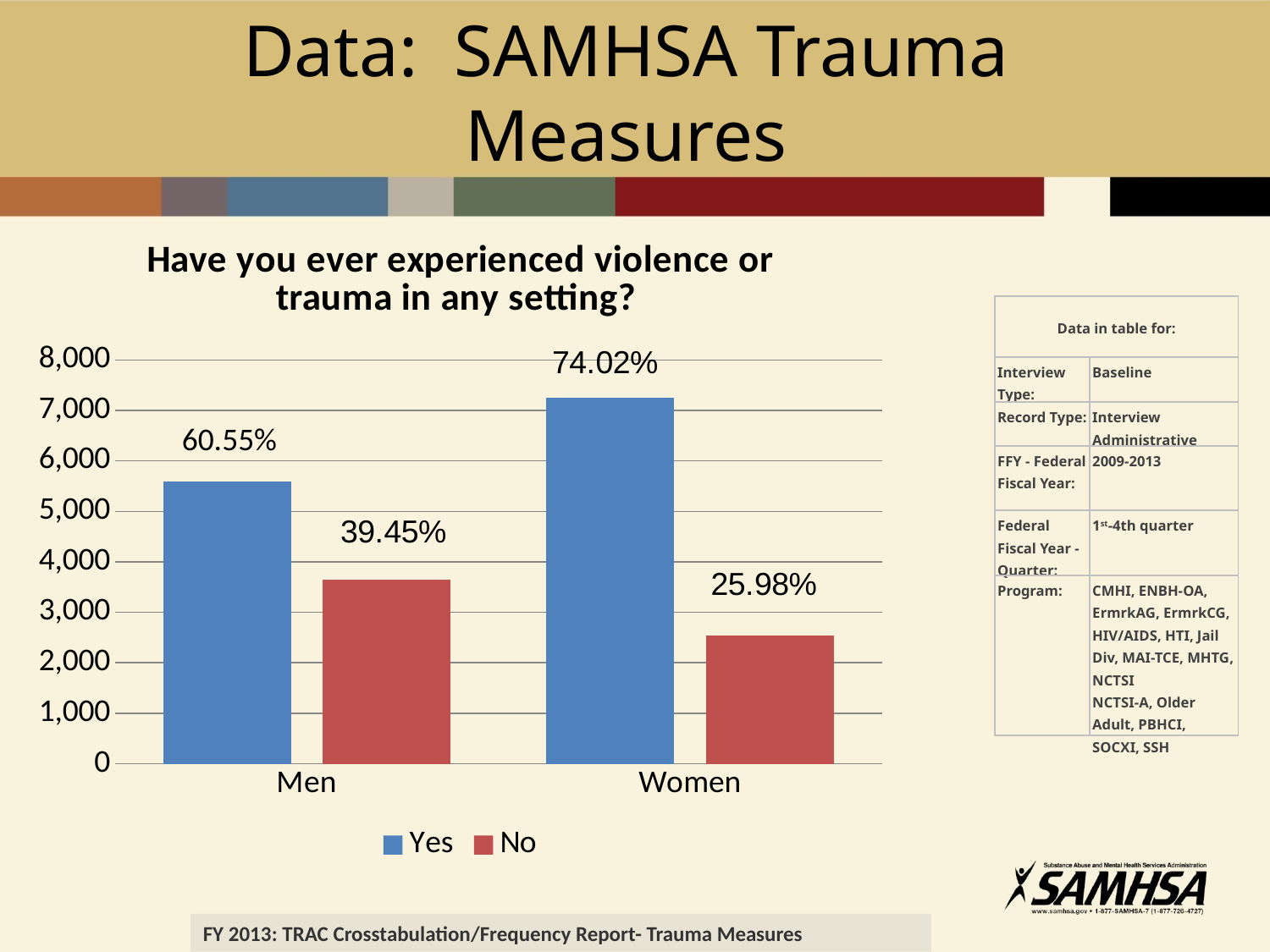
Which is larger, the No bar for Men or the No bar for Women? No bar for Men What is the data label shown on the Yes bar for Women? 74.02% How many series does the legend list? 2 What is the data label shown on the No bar for Women? 25.98% Is the Yes bar for Men greater or less than 5,000 on the y axis? greater Is the Yes bar for Women greater or less than 7,000 on the y axis? greater What type of chart is shown on the slide? Bar chart What is the data label shown on the No bar for Men? 39.45% Is the No bar for Women greater or less than 3,000 on the y axis? less Which bar has the lowest value in the chart? Women, No Which bar has the highest value in the chart? Women, Yes What is the data label shown on the Yes bar for Men? 60.55%